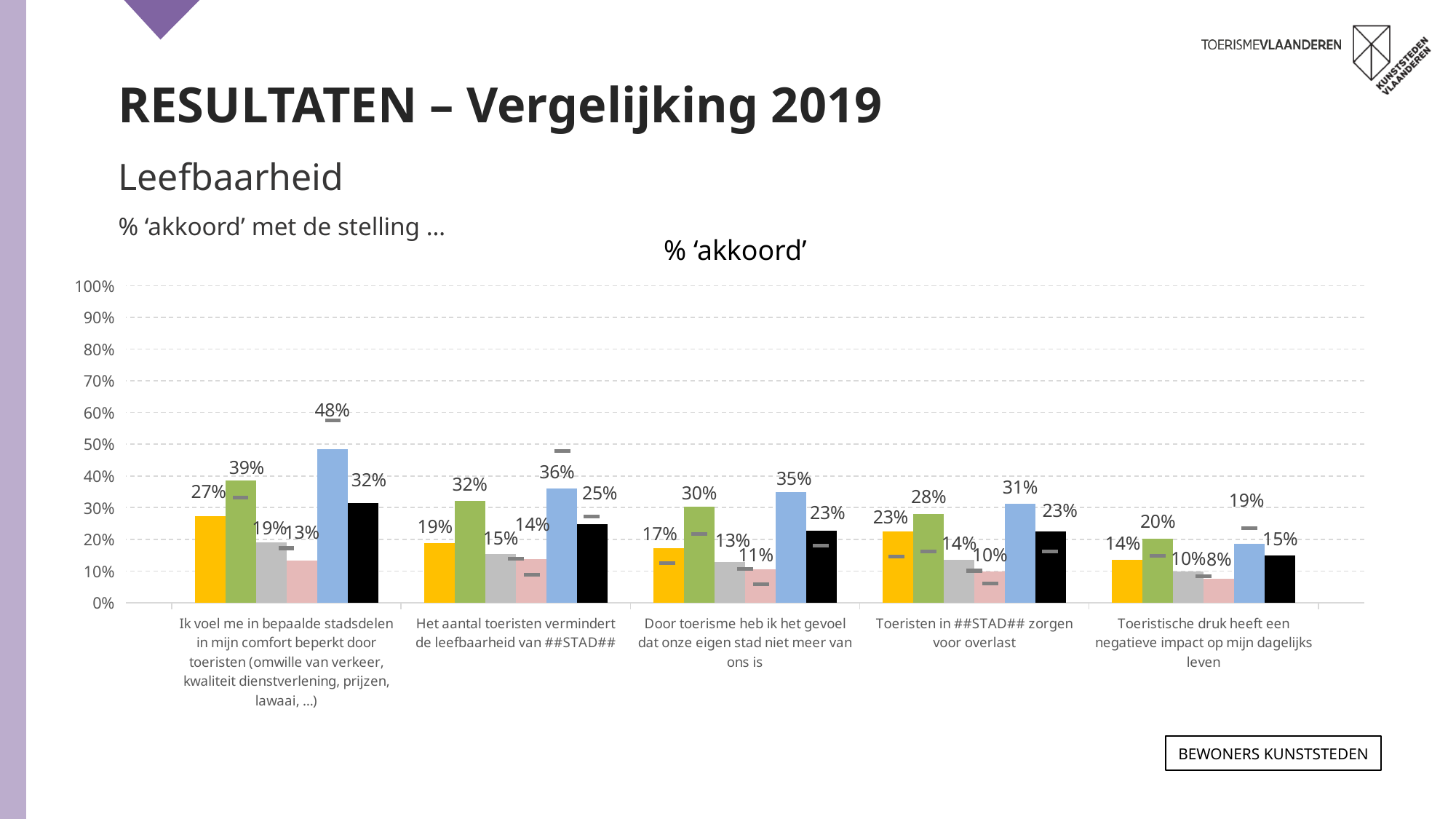
Which bar has the lowest value for the statement 'Toeristische druk heeft een negatieve impact op mijn dagelijks leven'? the pink bar (8%) How many statement categories are shown along the x axis of the chart? 5 Is the value of the blue bar for 'Het aantal toeristen vermindert de leefbaarheid van ##STAD##' greater or less than 30%? greater What type of chart is shown on the slide? bar chart What is the title of the chart? % ‘akkoord’ What is the highest value shown in the whole chart, and for which statement? 48%, 'Ik voel me in bepaalde stadsdelen in mijn comfort beperkt door toeristen' What is the value of the green bar for the statement 'Het aantal toeristen vermindert de leefbaarheid van ##STAD##'? 32% For the statement 'Toeristische druk heeft een negatieve impact op mijn dagelijks leven', which is larger: the green bar or the blue bar? the green bar (20%) What is the difference between the blue bar (48%) and the black bar (32%) for the statement 'Ik voel me in bepaalde stadsdelen in mijn comfort beperkt door toeristen'? 16 percentage points What is the value of the blue bar for the statement 'Toeristen in ##STAD## zorgen voor overlast'? 31% Looking at the blue bars from left to right across the five statements, do the values generally rise or fall? fall What is the value of the yellow bar for the statement 'Door toerisme heb ik het gevoel dat onze eigen stad niet meer van ons is'? 17%